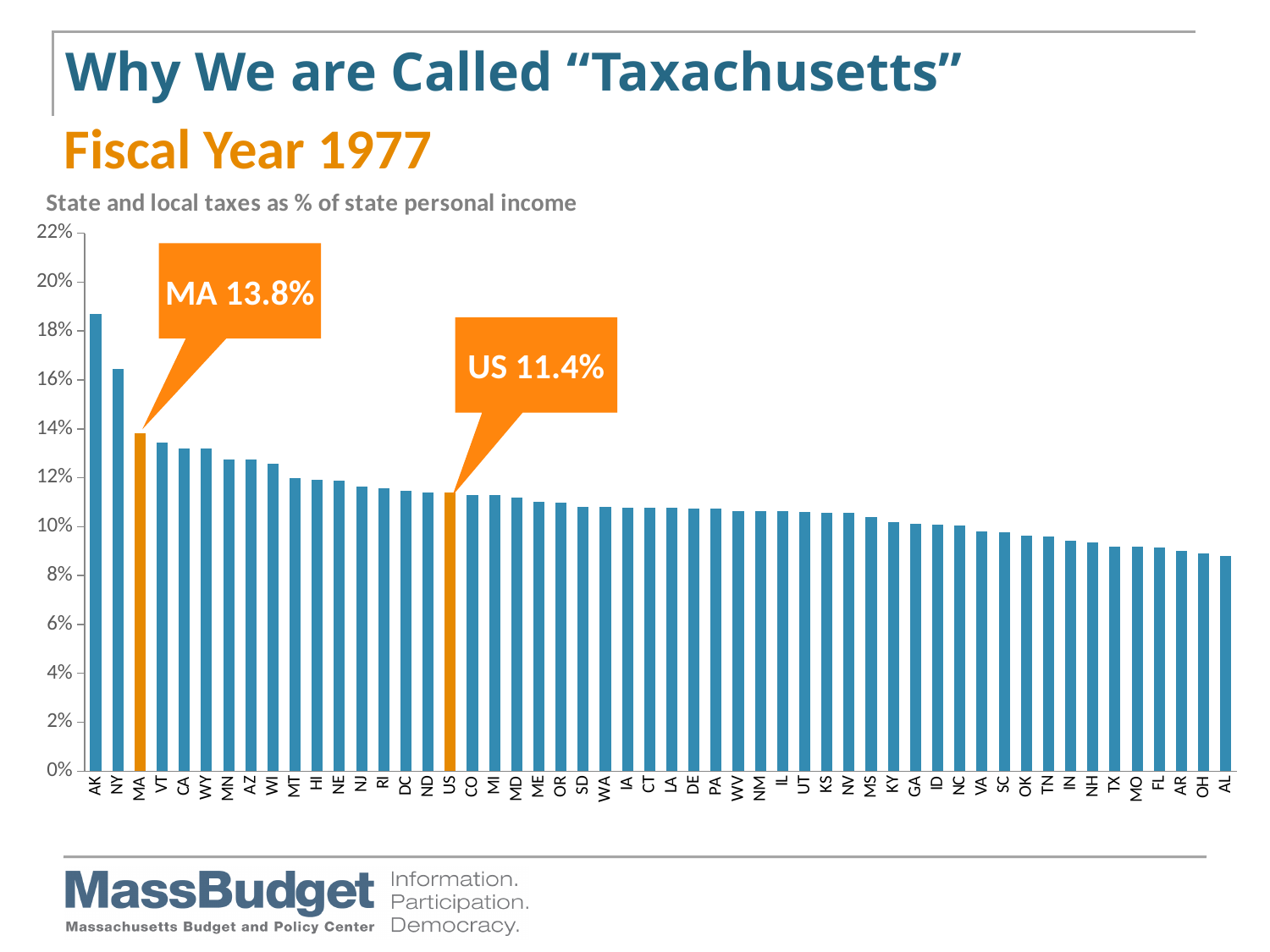
Which has a larger value, AK or NY? AK What colour are the MA and US bars highlighted in? orange Which state has the highest state and local taxes as a percent of personal income? AK Which state has the lowest value on the chart? AL Do the values rise or fall moving from left to right along the x axis? fall What is the value shown for US? 11.4% What kind of chart is shown on the slide? bar chart By how many percentage points does MA exceed the US value? 2.4 percentage points Is the value for NY greater or less than 16%? greater Is the value for AL greater or less than 10%? less What is the value shown for MA? 13.8% Is the value for AK greater or less than 18%? greater